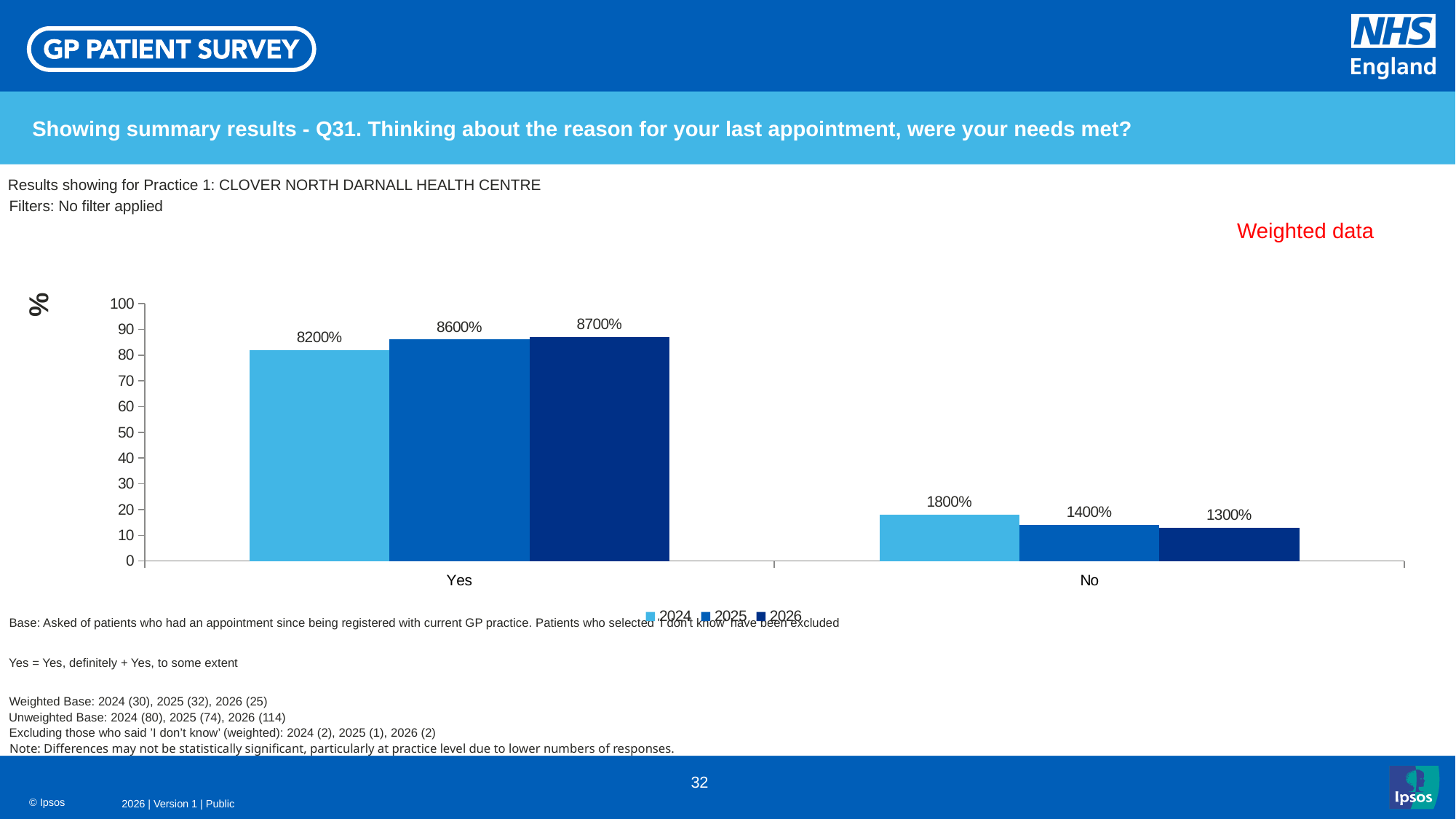
How many categories are shown on the x axis? 2 What is the value for 2026 in the No category? 1300% Is the 2024 bar for No above or below the 20 mark on the axis? below How many series does the legend list? 3 What is the difference between the 2024 and 2026 values in the No category, as labelled? 500% Which year has the lowest value in the No category? 2026 What kind of chart is shown on the slide? bar chart Which is larger: the 2024 value for Yes or the 2025 value for Yes? 2025 value for Yes What is the value for 2025 in the Yes category? 8600% Which practice are the results shown for? Practice 1: CLOVER NORTH DARNALL HEALTH CENTRE Which year has the highest value in the Yes category? 2026 What is the value for 2024 in the Yes category? 8200%